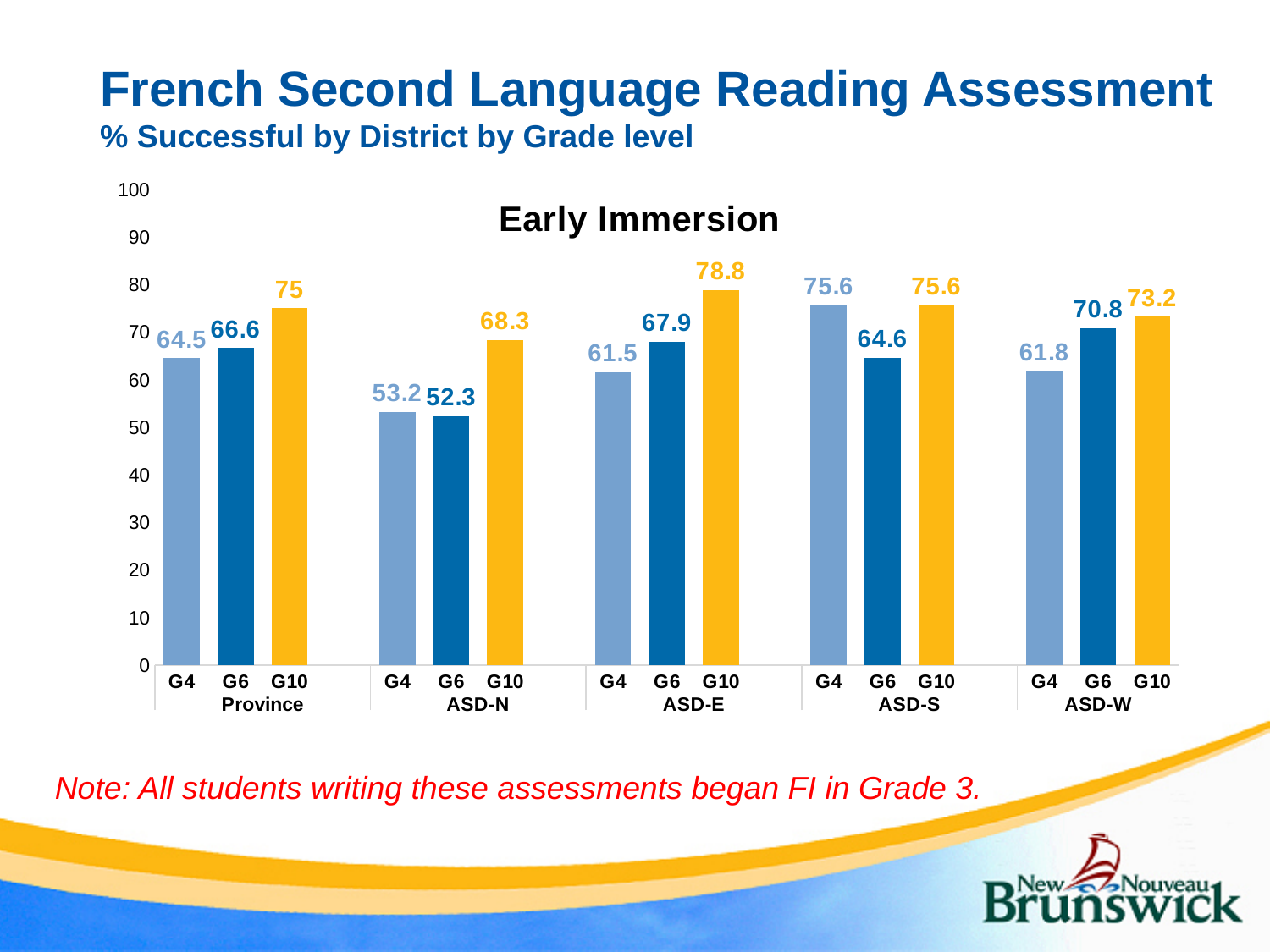
Which is larger, the G6 value for ASD-S or the G6 value for ASD-W? ASD-W (70.8) How many district groups are shown on the x axis? 5 What is the value for G10 in ASD-W? 73.2 Is the G4 value for ASD-S greater or less than 70? greater What kind of chart is shown on the slide? Bar chart What is the value for G6 in ASD-E? 67.9 What is the title shown above the chart? Early Immersion What is the value for G10 in the Province group? 75 Which bar has the highest value on the chart? G10 in ASD-E (78.8) Which bar has the lowest value on the chart? G6 in ASD-N (52.3) What is the value for G4 in ASD-N? 53.2 What is the difference between the G10 and G4 values in ASD-N? 15.1